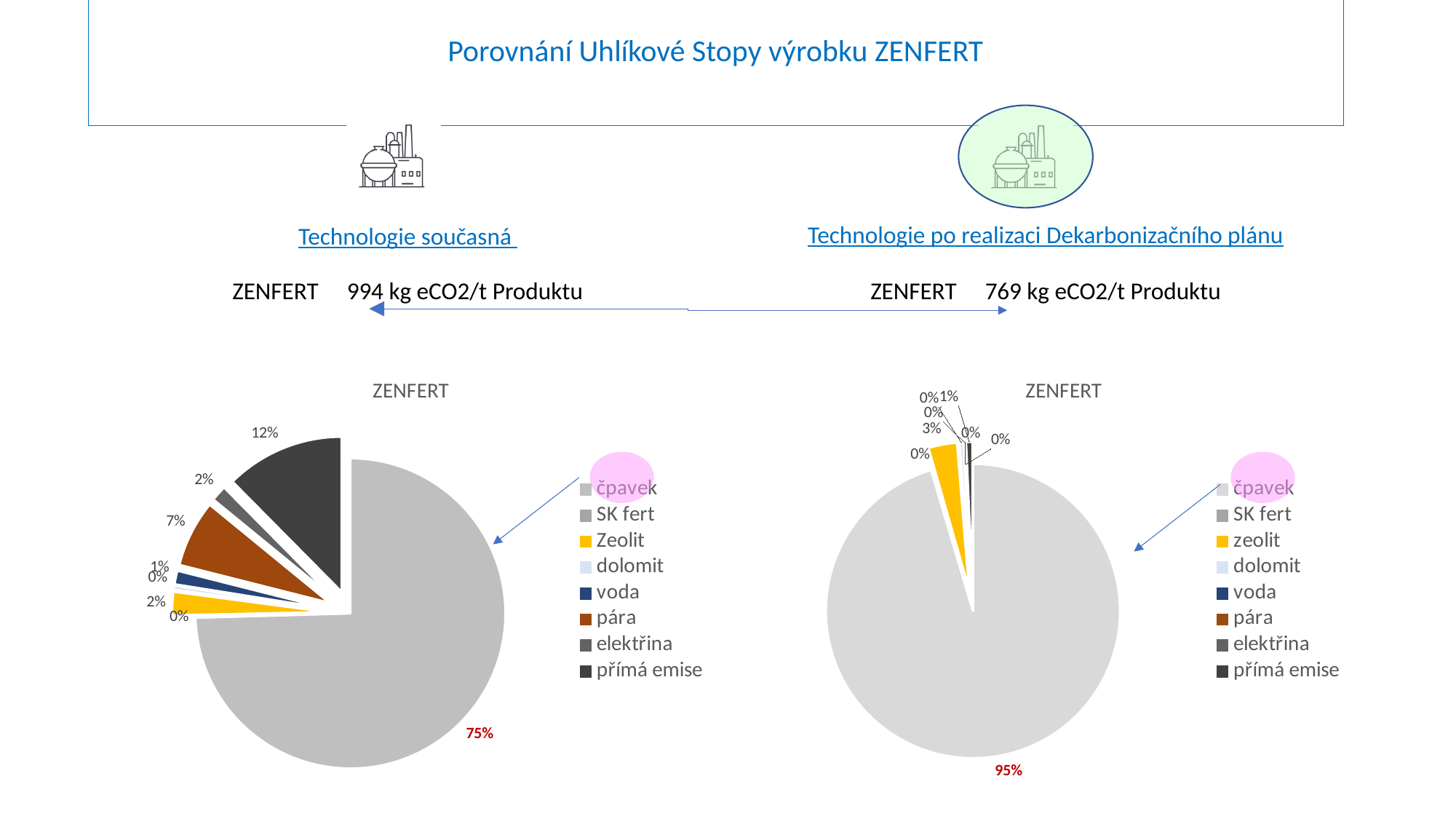
In the right pie chart (Technologie po realizaci Dekarbonizačního plánu), which category has the largest slice? čpavek In the left pie chart (Technologie současná), what share does čpavek have? 75% In the left pie chart (Technologie současná), what share does pára have? 7% In the right pie chart (Technologie po realizaci Dekarbonizačního plánu), what share does čpavek have? 95% In the left pie chart (Technologie současná), which is larger: pára or přímá emise? přímá emise What kind of chart is the left chart under 'Technologie současná'? pie chart What is the title shown above each pie chart? ZENFERT How many percentage points higher is the čpavek share in the right pie chart than in the left pie chart? 20% In the left pie chart (Technologie současná), what share does přímá emise have? 12% How many entries does the legend of the left pie chart list? 8 In the right pie chart (Technologie po realizaci Dekarbonizačního plánu), what share does zeolit have? 3% In the left pie chart (Technologie současná), which category has the largest slice? čpavek